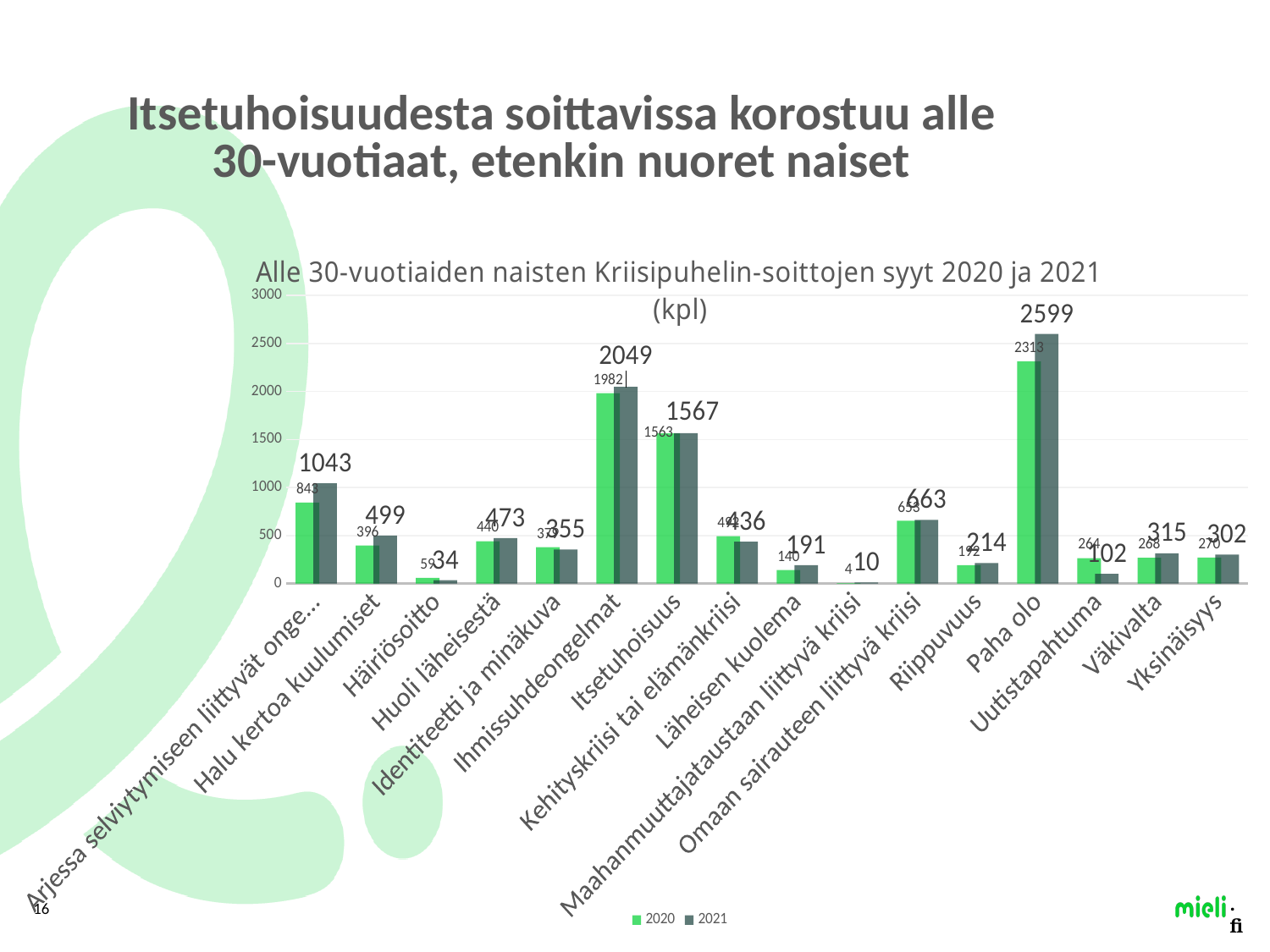
Which category has the highest 2021 value? Paha olo What kind of chart is shown on the slide? Bar chart What is the difference between the 2021 and 2020 values for Arjessa selviytymiseen liittyvät ongelmat? 200 Is the 2021 value for Itsetuhoisuus greater or less than 1500? greater For Uutistapahtuma, which year has the larger value, 2020 or 2021? 2020 Which category has the lowest 2021 value? Maahanmuuttajataustaan liittyvä kriisi How much higher is the 2021 value than the 2020 value for Paha olo? 286 What is the 2021 value for Läheisen kuolema? 191 How many series does the legend list? 2 How many categories are shown on the x axis? 16 What is the 2020 value for Ihmissuhdeongelmat? 1982 What is the 2021 value for Paha olo? 2599